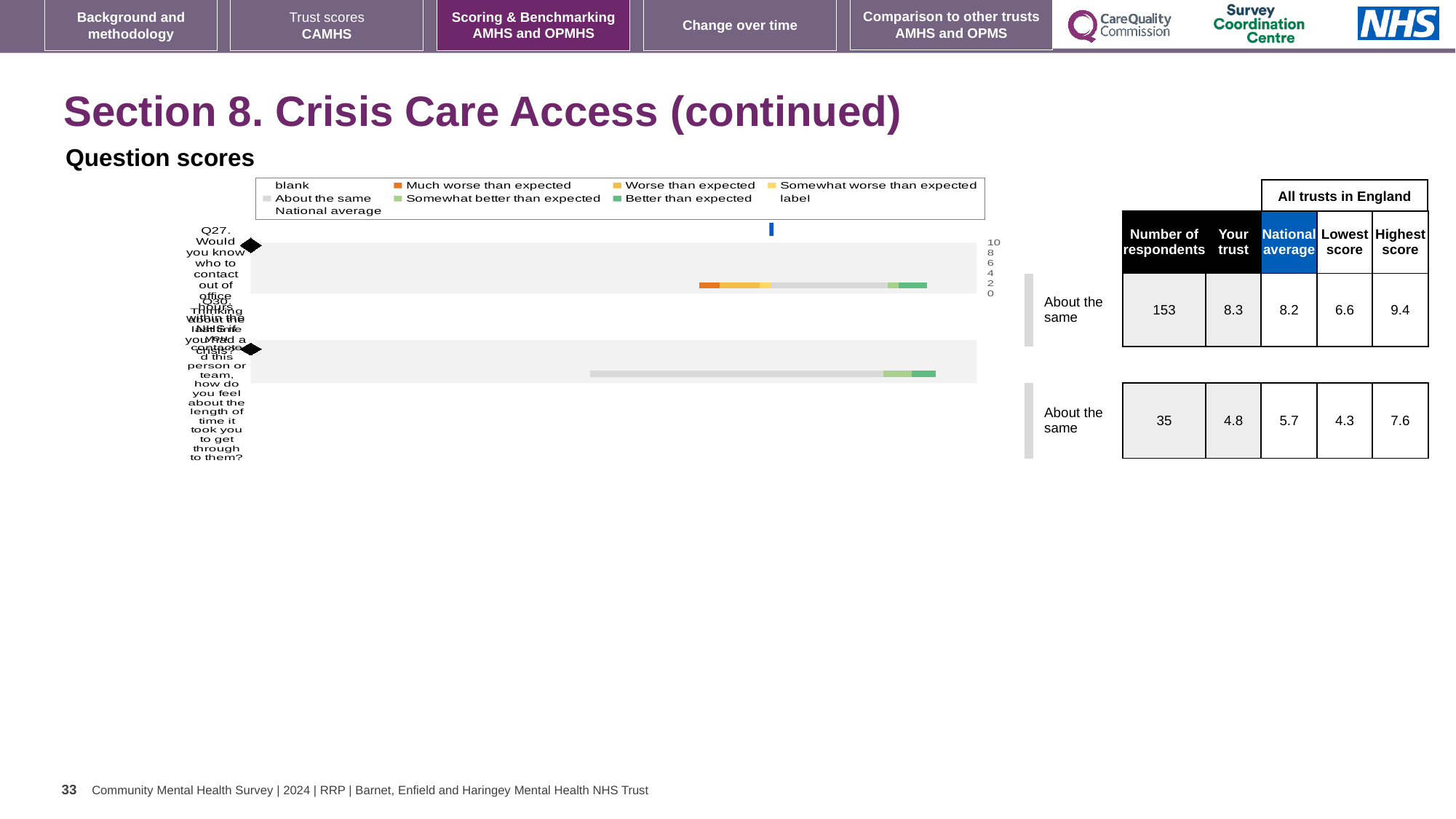
What benchmark category is shown for Q30? About the same What kind of chart is shown under 'Question scores'? bar chart What is the difference between the highest score and the lowest score for Q27? 2.8 What is the number of respondents for Q30? 35 What is the 'Your trust' score for Q27? 8.3 What is the national average score for Q30? 5.7 How many questions (bars) are plotted in the chart? 2 What is the highest value shown on the chart's score axis? 10 How many entries does the chart legend list? 9 Which question has the higher 'Your trust' score, Q27 or Q30? Q27 What colour does the legend use for 'Much worse than expected'? orange